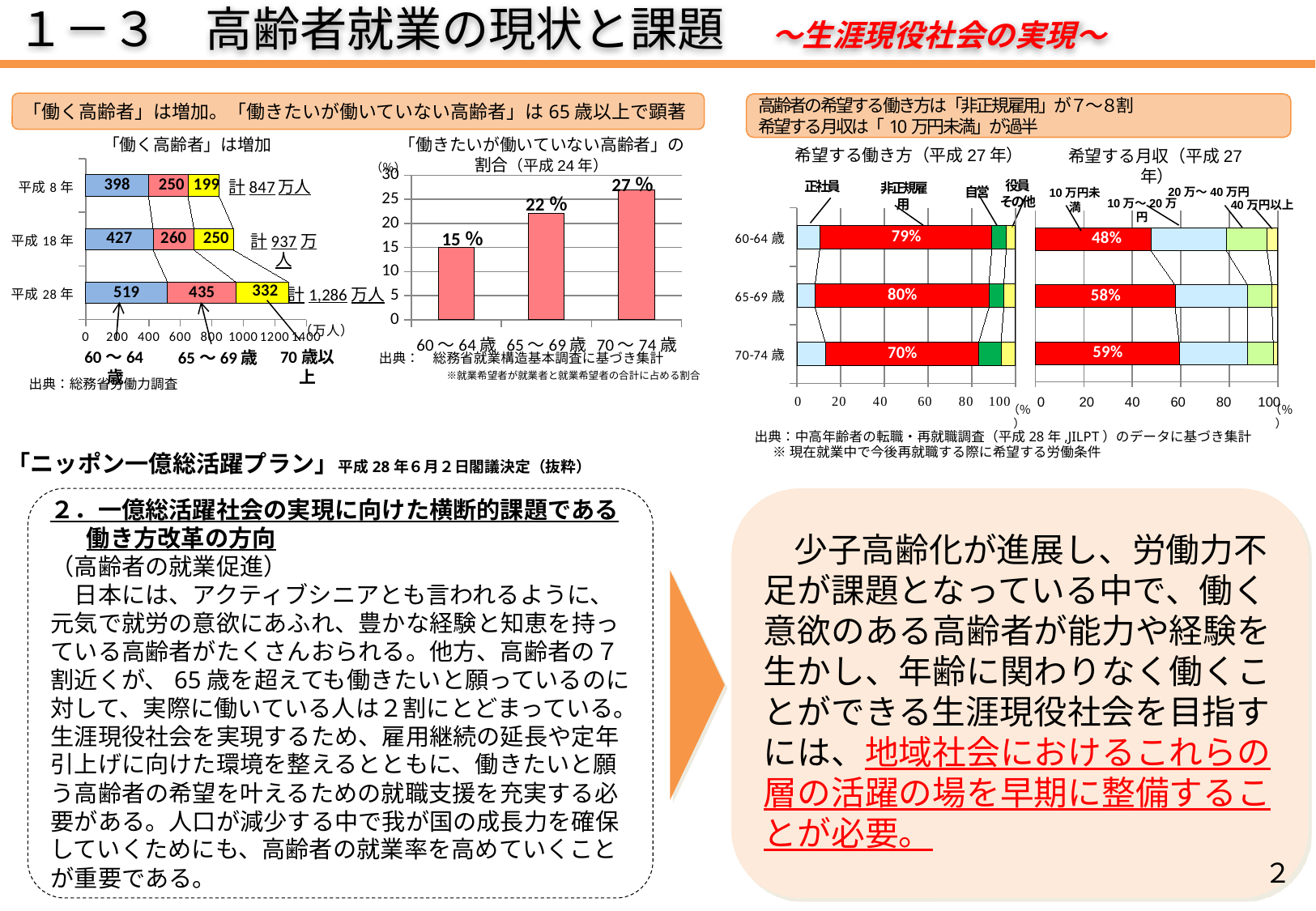
希望する働き方（平成27年）のグラフで、65-69歳の非正規雇用の割合はいくつですか？ 80% 希望する月収（平成27年）のグラフで、60-64歳の10万円未満の割合はいくつですか？ 48% 希望する働き方（平成27年）のグラフで、非正規雇用の割合が最も低い年齢層はどれですか？ 70-74歳 「働く高齢者」は増加のグラフで、平成8年の70歳以上の値はいくつですか？ 199 「働きたいが働いていない高齢者」の割合（平成24年）のグラフで、最も高い年齢層はどれですか？ 70～74歳 「働く高齢者」は増加のグラフで、平成28年と平成8年の65～69歳の値の差はいくつですか？ 185 「働く高齢者」は増加のグラフで、平成18年の合計はいくつですか？ 計937万人 「働く高齢者」は増加のグラフで、平成28年の60～64歳の値はいくつですか？ 519 「働きたいが働いていない高齢者」の割合（平成24年）のグラフは、どの種類のグラフですか？ 棒グラフ 「働く高齢者」は増加のグラフの凡例には、いくつの系列がありますか？ 3 「働きたいが働いていない高齢者」の割合（平成24年）のグラフで、65～69歳の値はいくつですか？ 22% 「働きたいが働いていない高齢者」の割合（平成24年）のグラフで、値は年齢層が上がるにつれて増加していますか、減少していますか？ 増加